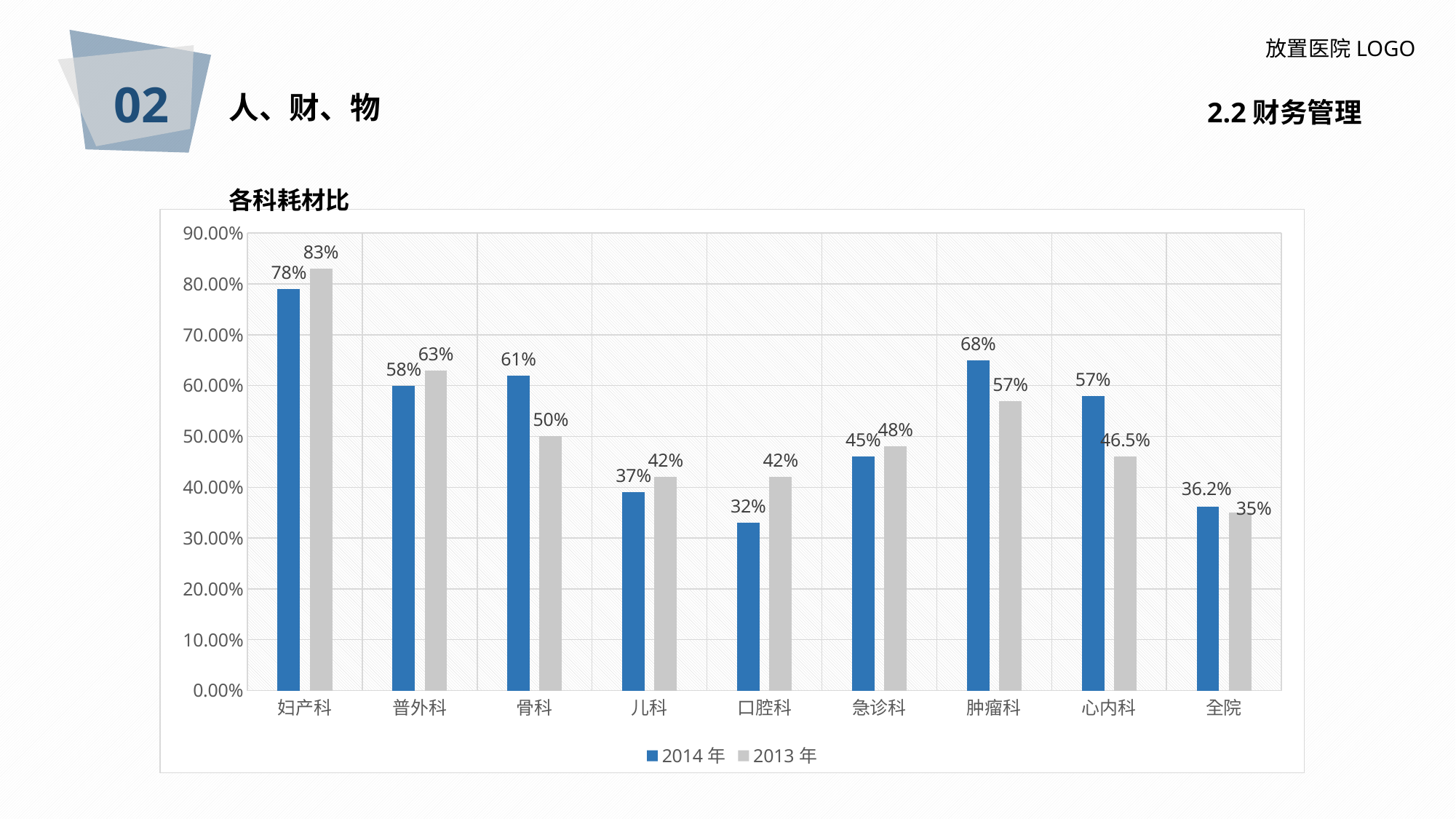
What is the 2013 年 value for 心内科? 46.5% What is the difference between the 2014 年 values for 妇产科 and 普外科? 20% What is the difference between the 2013 年 and 2014 年 values for 口腔科? 10% How many series does the legend list? 2 Which category has the highest 2013 年 value? 妇产科 Which is larger for 肿瘤科, the 2014 年 value or the 2013 年 value? 2014 年 What is the 2014 年 value for 全院? 36.2% How many categories are shown on the x axis? 9 What type of chart is shown on the slide? bar chart What is the 2014 年 value for 骨科? 61% Which category has the lowest 2014 年 value? 口腔科 What is the title of the chart? 各科耗材比